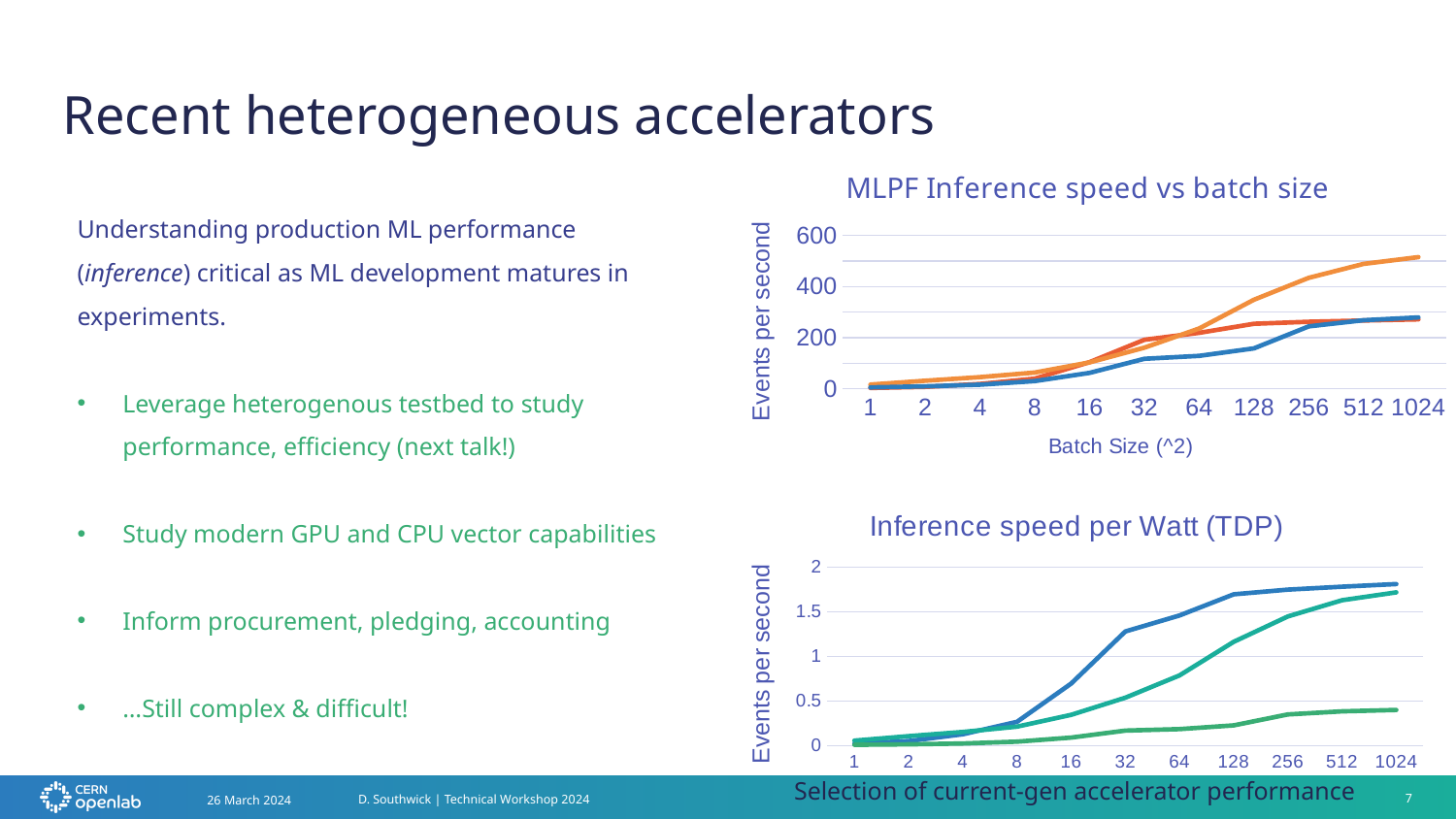
In the 'MLPF Inference speed vs batch size' chart, how many batch size values are shown on the x axis? 11 What kind of chart is the 'Inference speed per Watt (TDP)' chart? line chart In the 'Inference speed per Watt (TDP)' chart, do the plotted values rise or fall as batch size increases? rise In the 'Inference speed per Watt (TDP)' chart, how many batch size values are shown on the x axis? 11 In the 'MLPF Inference speed vs batch size' chart, do the plotted values rise or fall as batch size increases? rise In the 'MLPF Inference speed vs batch size' chart, is the value of the orange line at batch size 1024 greater or less than 400? greater What is the x-axis title of the 'MLPF Inference speed vs batch size' chart? Batch Size (^2) In the 'MLPF Inference speed vs batch size' chart, is the value of the blue line at batch size 1024 greater or less than 400? less In the 'MLPF Inference speed vs batch size' chart, which line reaches the highest value at batch size 1024? the orange line In the 'Inference speed per Watt (TDP)' chart, is the value of the blue line at batch size 1024 greater or less than 1.5? greater What kind of chart is the 'MLPF Inference speed vs batch size' chart? line chart